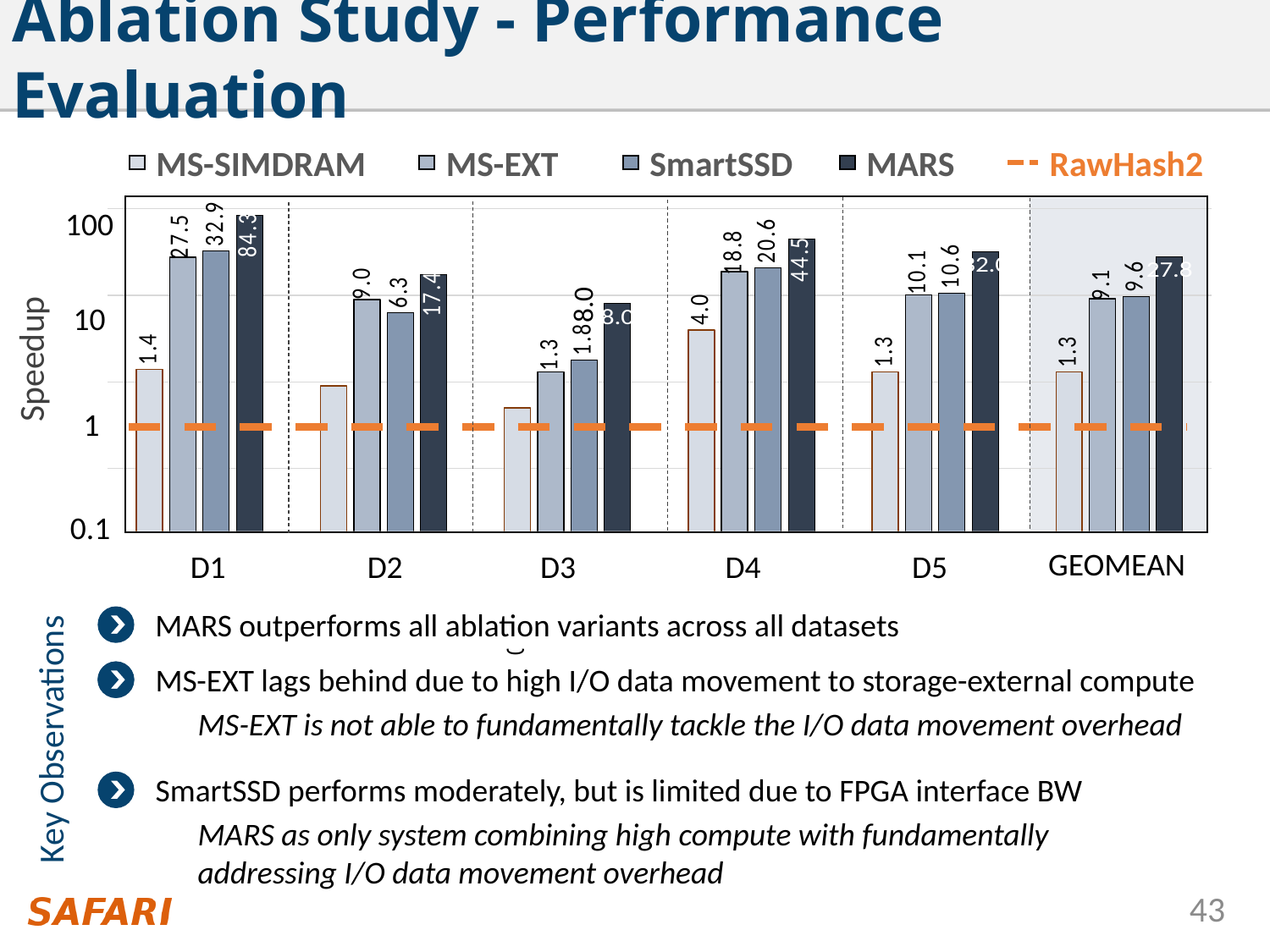
Which system has the lowest speedup on dataset D4? MS-SIMDRAM What kind of chart is shown on the slide? bar chart What is the speedup of MS-EXT on dataset D4? 18.8 What is the speedup of MS-SIMDRAM on dataset D4? 4.0 Is the speedup of MS-SIMDRAM on dataset D2 greater or less than 10? less What is the speedup of SmartSSD on dataset D2? 6.3 What is the difference between the MARS and SmartSSD speedups on dataset D1? 51.4 On dataset D2, which has the larger speedup, MS-EXT or SmartSSD? MS-EXT What is the speedup of MARS on dataset D1? 84.3 Which system has the highest speedup on dataset D1? MARS How many dataset categories are shown on the x axis? 6 How many entries does the legend list? 5